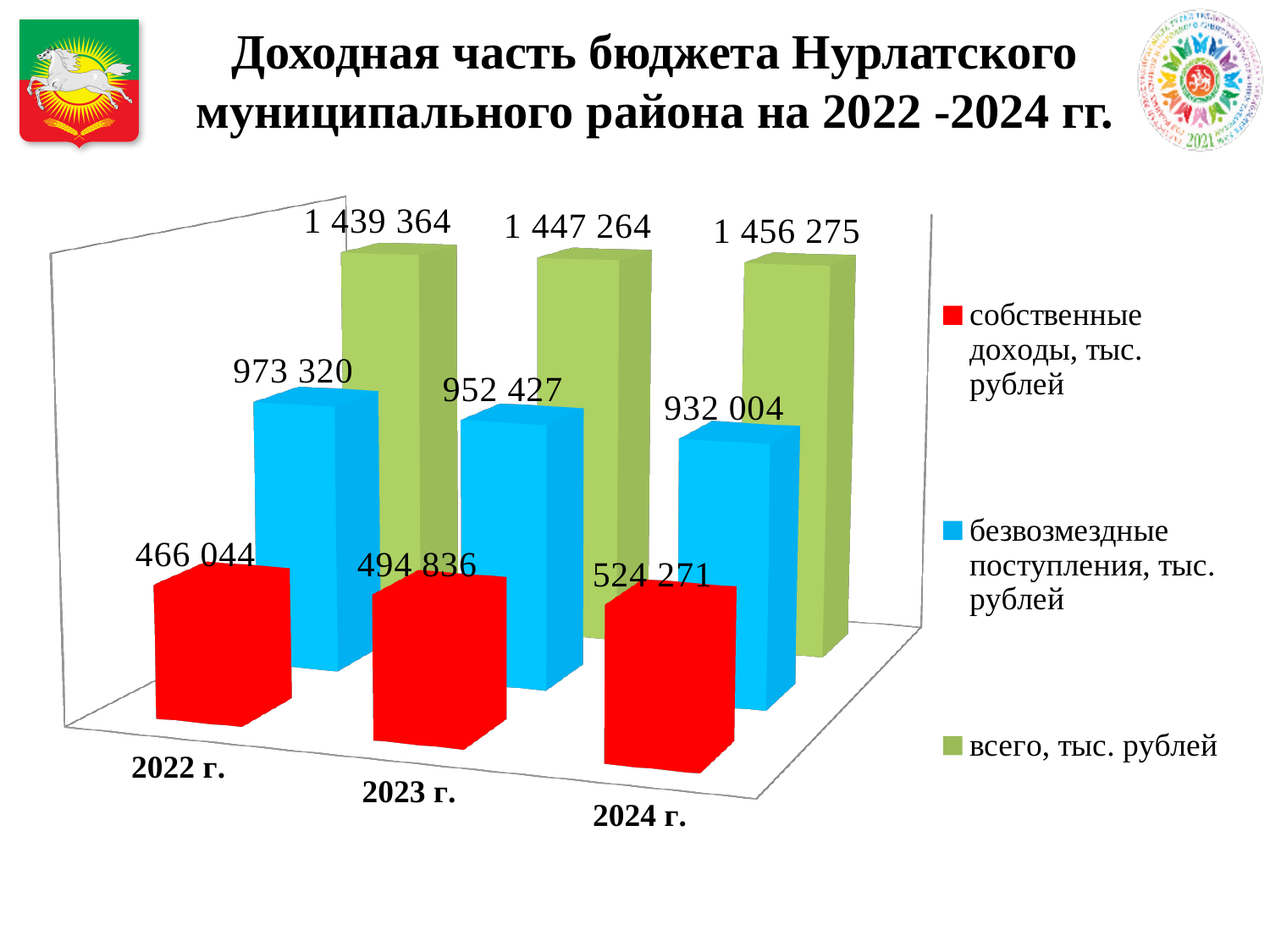
What kind of chart is shown on the slide? bar chart What is the value of безвозмездные поступления for 2024 г.? 932 004 What is the value of всего for 2023 г.? 1 447 264 How many years are shown on the x axis? 3 What is the difference between собственные доходы in 2024 г. and in 2022 г.? 58 227 In which year is безвозмездные поступления the lowest? 2024 г. What is the difference between безвозмездные поступления in 2022 г. and in 2024 г.? 41 316 How many series does the legend list? 3 What is the value of собственные доходы for 2022 г.? 466 044 Which is larger: всего in 2024 г. or всего in 2022 г.? всего in 2024 г. In which year is собственные доходы the highest? 2024 г. Do the values of собственные доходы rise or fall from 2022 г. to 2024 г.? rise